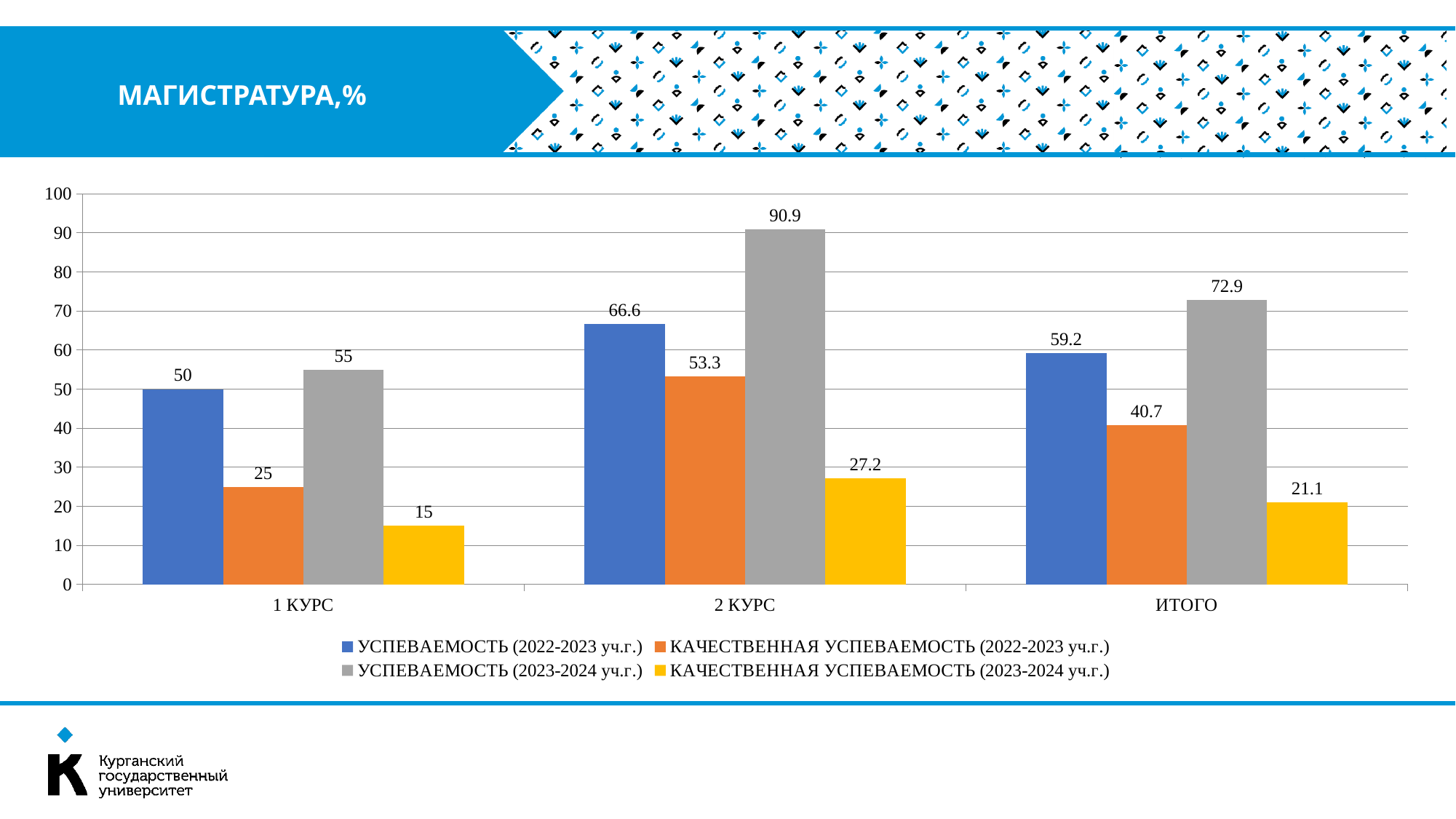
Which is larger for ИТОГО: КАЧЕСТВЕННАЯ УСПЕВАЕМОСТЬ (2022-2023 уч.г.) or КАЧЕСТВЕННАЯ УСПЕВАЕМОСТЬ (2023-2024 уч.г.)? КАЧЕСТВЕННАЯ УСПЕВАЕМОСТЬ (2022-2023 уч.г.) Which category has the highest value for КАЧЕСТВЕННАЯ УСПЕВАЕМОСТЬ (2023-2024 уч.г.)? 2 КУРС What is the value of УСПЕВАЕМОСТЬ (2023-2024 уч.г.) for 2 КУРС? 90.9 What colour are the bars for КАЧЕСТВЕННАЯ УСПЕВАЕМОСТЬ (2023-2024 уч.г.)? yellow Which category has the lowest value for УСПЕВАЕМОСТЬ (2022-2023 уч.г.)? 1 КУРС Is the value of УСПЕВАЕМОСТЬ (2023-2024 уч.г.) for ИТОГО greater or less than 70? greater What is the value of КАЧЕСТВЕННАЯ УСПЕВАЕМОСТЬ (2022-2023 уч.г.) for 1 КУРС? 25 What kind of chart is shown on the slide? bar chart How many categories are shown on the x axis? 3 What is the difference between УСПЕВАЕМОСТЬ (2023-2024 уч.г.) and УСПЕВАЕМОСТЬ (2022-2023 уч.г.) for 2 КУРС? 24.3 What is the value of УСПЕВАЕМОСТЬ (2022-2023 уч.г.) for ИТОГО? 59.2 How many series does the legend list? 4